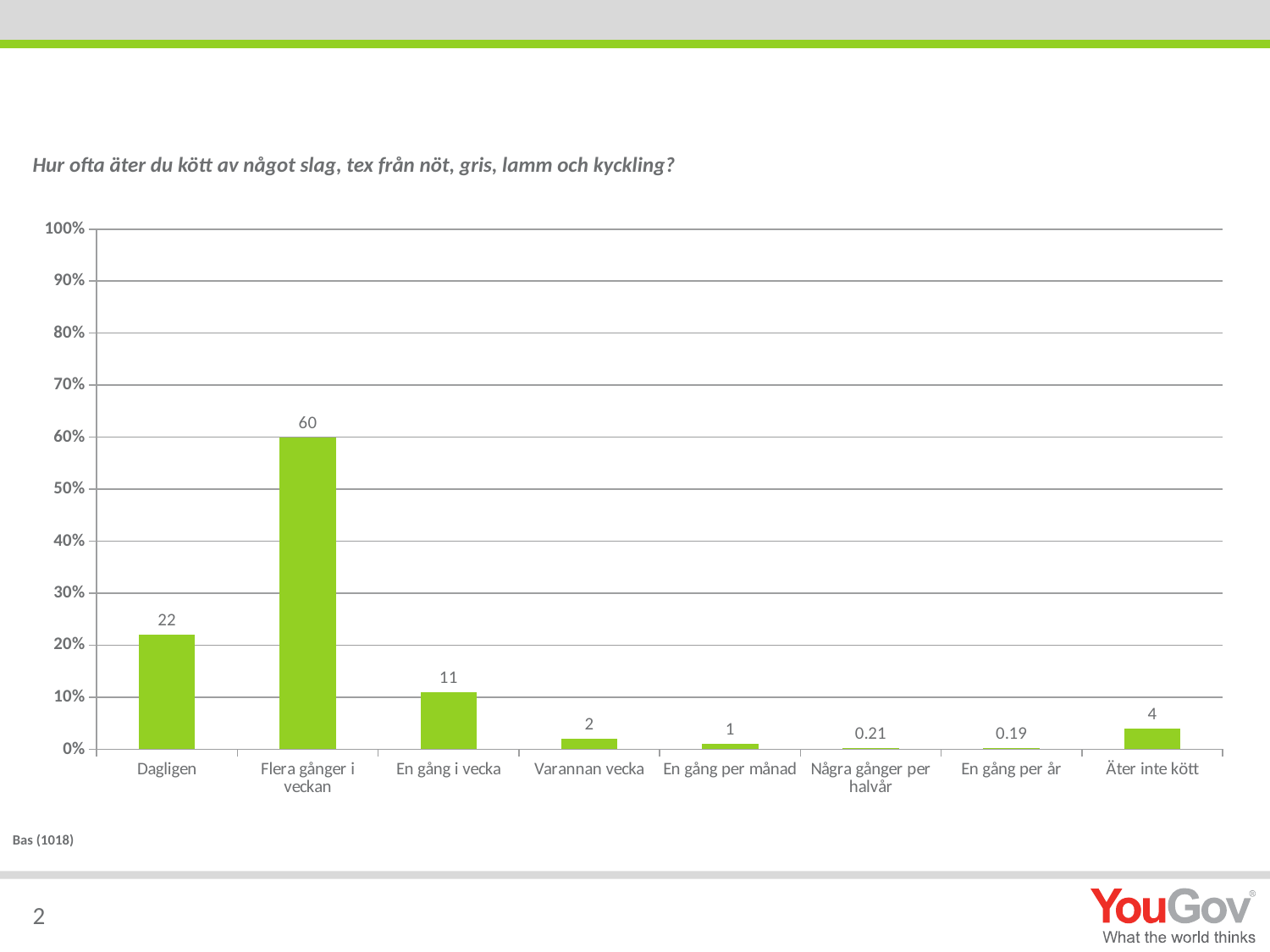
What is the value for "Dagligen"? 22 How many categories are shown on the x axis? 8 What is the value for "Flera gånger i veckan"? 60 Which category has the highest value? Flera gånger i veckan What kind of chart is shown on the slide? bar chart Which is larger, the value for "En gång i vecka" or the value for "Äter inte kött"? En gång i vecka What is the value for "Äter inte kött"? 4 Which category has the lowest value? En gång per år What is the base (Bas) shown below the chart? 1018 What is the difference between the values for "Flera gånger i veckan" and "Dagligen"? 38 What is the value for "Några gånger per halvår"? 0.21 Is the value for "Dagligen" greater or less than 30%? less